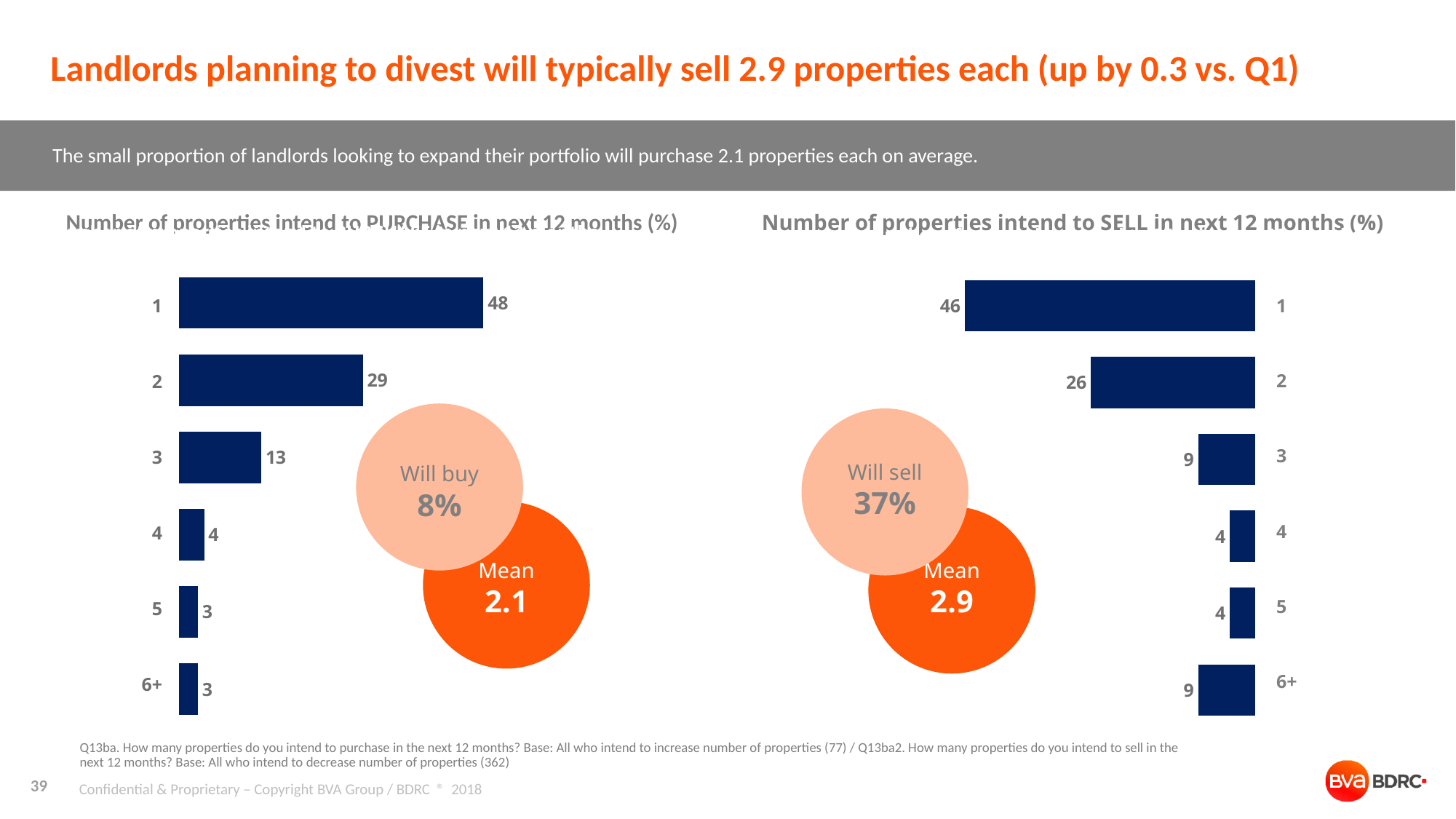
In the 'Number of properties intend to SELL in next 12 months (%)' chart, what is the difference between the values for category 1 and category 3? 37 How many categories are shown in the 'Number of properties intend to SELL in next 12 months (%)' chart? 6 In the 'Number of properties intend to PURCHASE in next 12 months (%)' chart, what is the difference between the values for category 1 and category 2? 19 In the 'Number of properties intend to SELL in next 12 months (%)' chart, what is the value for category 6+? 9 What mean value is shown in the orange circle on the 'Number of properties intend to SELL in next 12 months (%)' chart? 2.9 What type of chart is the 'Number of properties intend to PURCHASE in next 12 months (%)' chart? Bar chart In the 'Number of properties intend to PURCHASE in next 12 months (%)' chart, do the values rise or fall from category 1 to category 4? Fall In the 'Number of properties intend to SELL in next 12 months (%)' chart, what is the value for category 2? 26 In the 'Number of properties intend to SELL in next 12 months (%)' chart, which category has the highest value? 1 In the 'Number of properties intend to PURCHASE in next 12 months (%)' chart, which category has the highest value? 1 In the 'Number of properties intend to PURCHASE in next 12 months (%)' chart, which is larger: the value for category 3 or the value for category 4? 3 In the 'Number of properties intend to PURCHASE in next 12 months (%)' chart, what is the value for category 1? 48